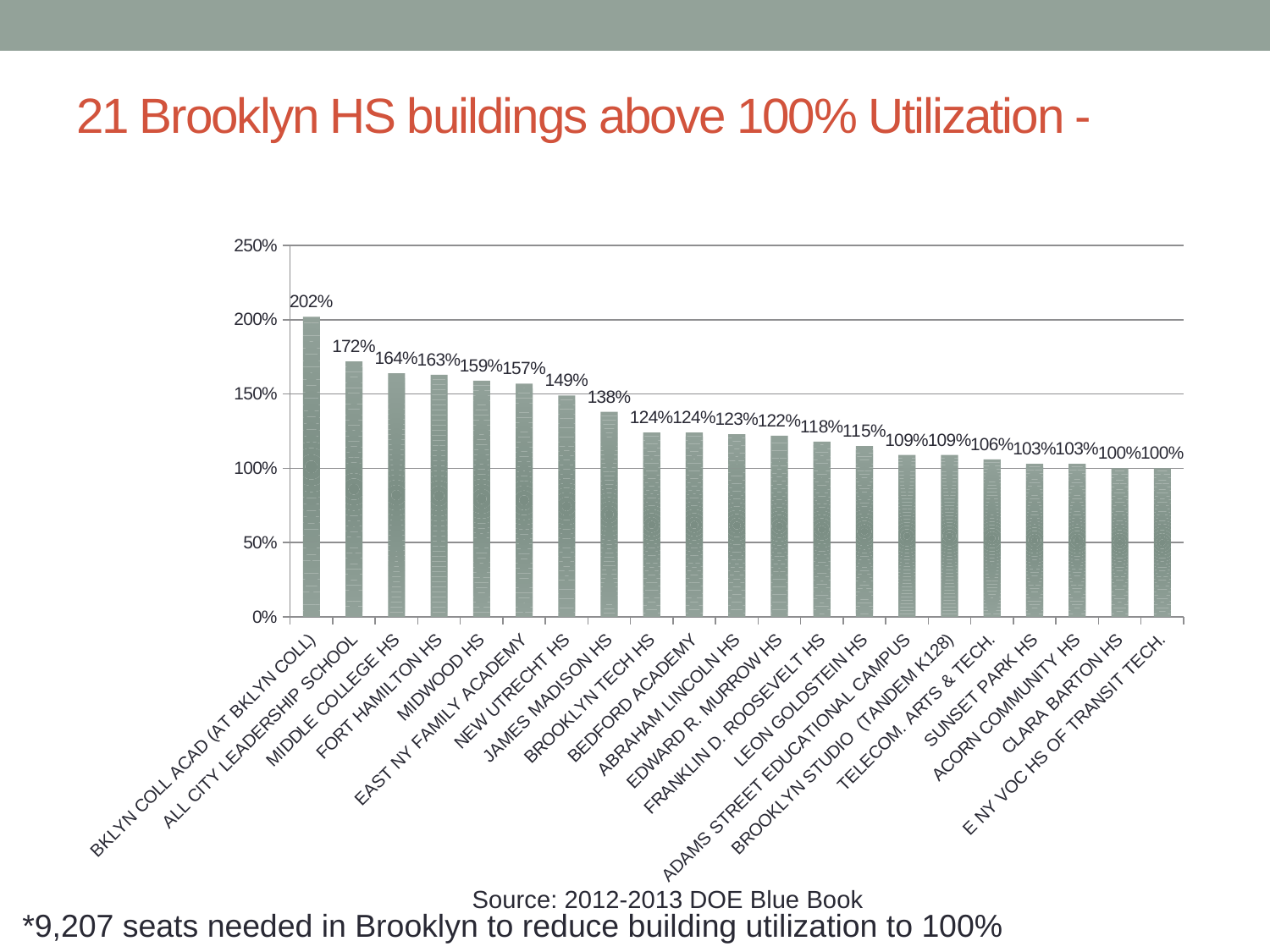
Which building has the highest utilization? BKLYN COLL ACAD (AT BKLYN COLL) What is the utilization value for JAMES MADISON HS? 138% Do the utilization values rise or fall from left to right across the chart? fall What is the lowest utilization value shown on the chart? 100% What is the utilization value for TELECOM. ARTS & TECH.? 106% What is the utilization value for FORT HAMILTON HS? 163% Is the value for EDWARD R. MURROW HS greater or less than 150%? less Which has a higher utilization, MIDWOOD HS or NEW UTRECHT HS? MIDWOOD HS What kind of chart is shown on the slide? bar chart What is the difference in utilization between BKLYN COLL ACAD (AT BKLYN COLL) and ALL CITY LEADERSHIP SCHOOL? 30 percentage points How many buildings are shown on the chart? 21 What is the utilization value for LEON GOLDSTEIN HS? 115%